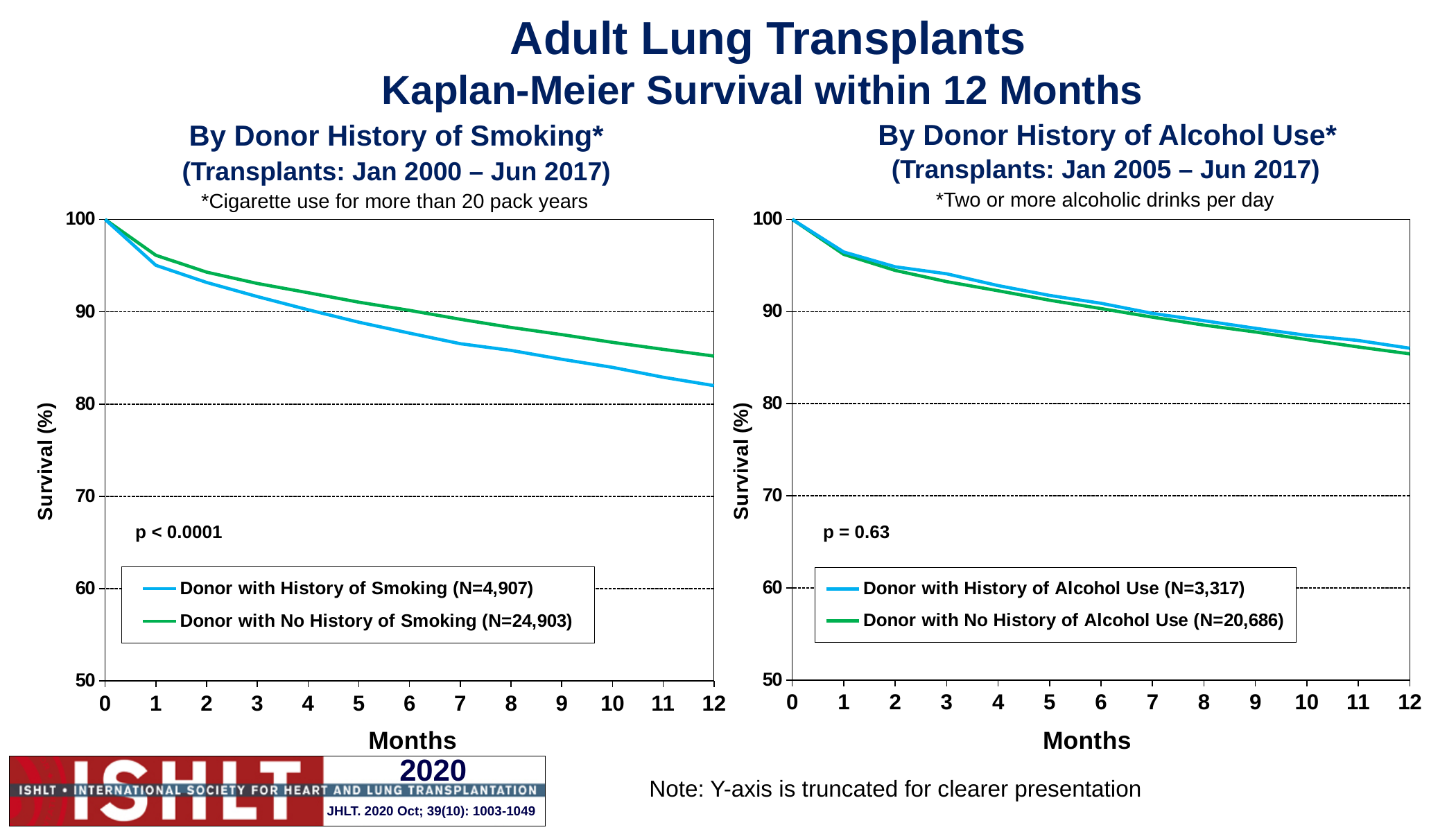
In the 'By Donor History of Alcohol Use' chart, what is the N for Donor with No History of Alcohol Use shown in the legend? 20,686 In the 'By Donor History of Smoking' chart, is the survival value for Donor with History of Smoking at month 12 greater or less than 90? less How many series does the legend list in the 'By Donor History of Alcohol Use' chart on the right? 2 What p-value is shown on the 'By Donor History of Smoking' chart? p < 0.0001 In the 'By Donor History of Alcohol Use' chart, is the survival value for Donor with No History of Alcohol Use at month 2 greater or less than 90? greater In the 'By Donor History of Smoking' chart, do the survival values rise or fall as months increase? fall What kind of chart is the 'By Donor History of Smoking' chart on the left? line chart In the 'By Donor History of Smoking' chart, what is the survival value for both series at month 0? 100 In the 'By Donor History of Alcohol Use' chart, is the survival value for Donor with History of Alcohol Use at month 12 greater or less than 90? less In the 'By Donor History of Smoking' chart, which series has the higher survival at month 12: Donor with History of Smoking or Donor with No History of Smoking? Donor with No History of Smoking